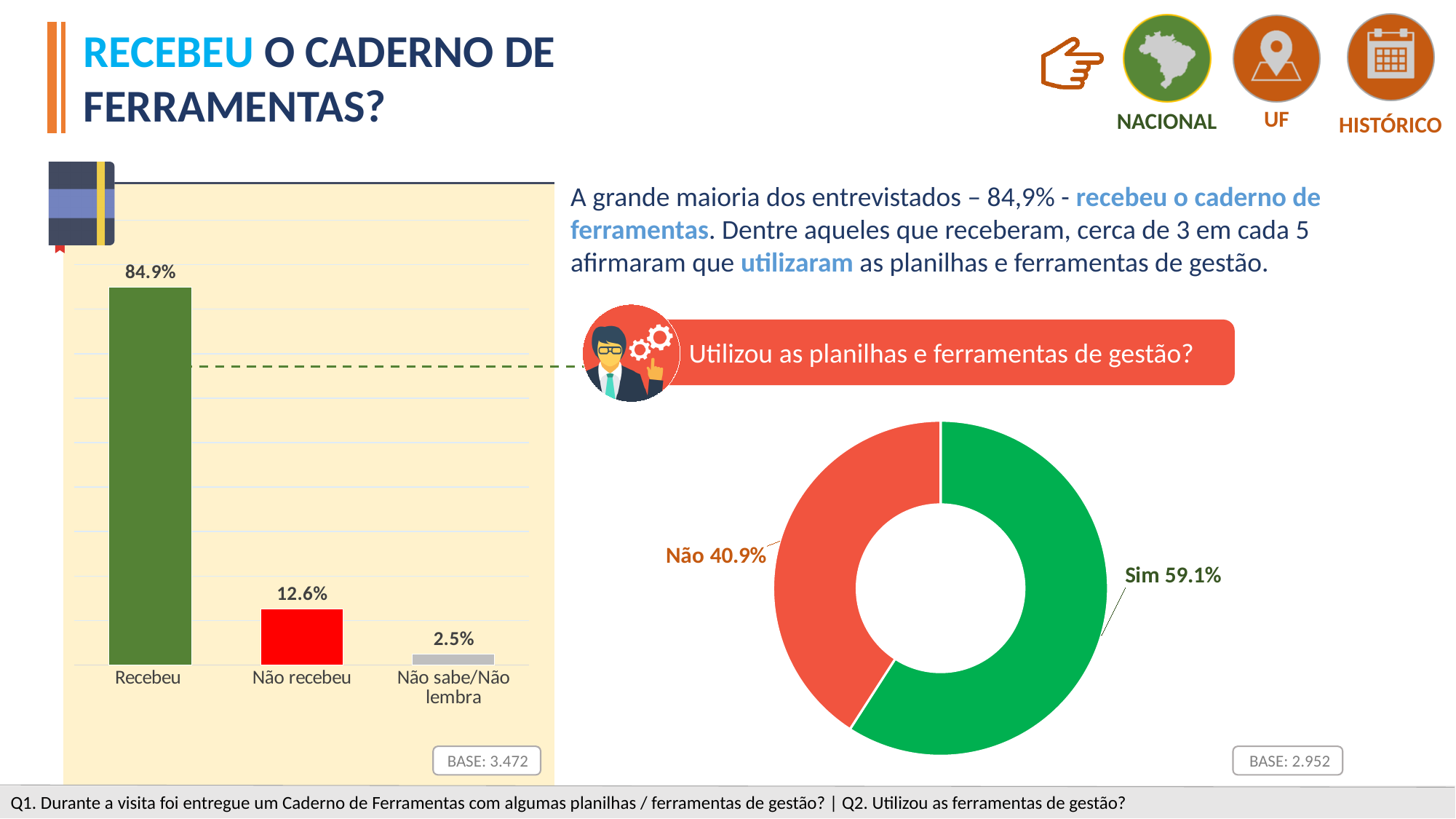
What kind of chart is the chart on the left of the slide? Bar chart In the bar chart on the left, which category has the highest value? Recebeu In the doughnut chart on the right, what is the difference between the 'Sim' and 'Não' shares? 18.2% In the doughnut chart on the right ('Utilizou as planilhas e ferramentas de gestão?'), what is the share for 'Não'? 40.9% In the bar chart on the left, what is the value for 'Recebeu'? 84.9% In the doughnut chart on the right ('Utilizou as planilhas e ferramentas de gestão?'), what is the share for 'Sim'? 59.1% In the bar chart on the left, which category has the lowest value? Não sabe/Não lembra In the doughnut chart on the right, which is larger, 'Sim' or 'Não'? Sim How many categories are shown in the bar chart on the left? 3 In the bar chart on the left, what is the value for 'Não recebeu'? 12.6% In the bar chart on the left, what is the difference between the values for 'Recebeu' and 'Não recebeu'? 72.3% In the bar chart on the left, what is the value for 'Não sabe/Não lembra'? 2.5%